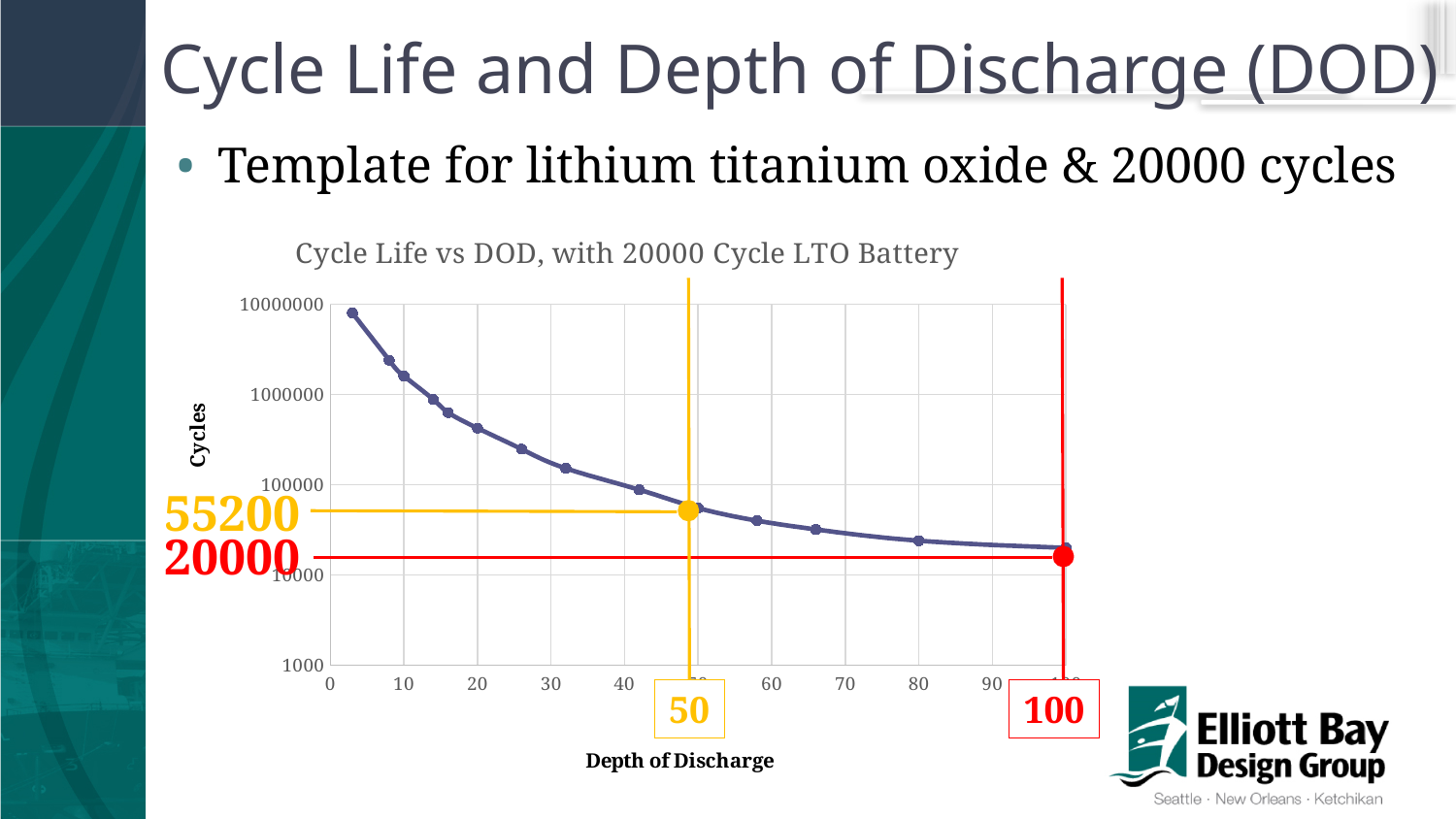
What is the title of the chart? Cycle Life vs DOD, with 20000 Cycle LTO Battery What is the cycle life at a depth of discharge of 100? 20000 Is the cycle life at a depth of discharge of 10 greater or less than 1000000? greater What kind of chart is shown on the slide? line chart What is the cycle life at a depth of discharge of 50? 55200 Of the two highlighted points, DOD 50 and DOD 100, which has the lower cycle life? 100 Is the cycle life at a depth of discharge of 20 greater or less than 100000? greater Which depth of discharge gives more cycles, 50 or 100? 50 What is the difference in cycles between a DOD of 50 and a DOD of 100? 35200 Do the cycles rise or fall as depth of discharge increases? fall What is the label of the x axis? Depth of Discharge Is the cycle life at a depth of discharge of 80 greater or less than 100000? less